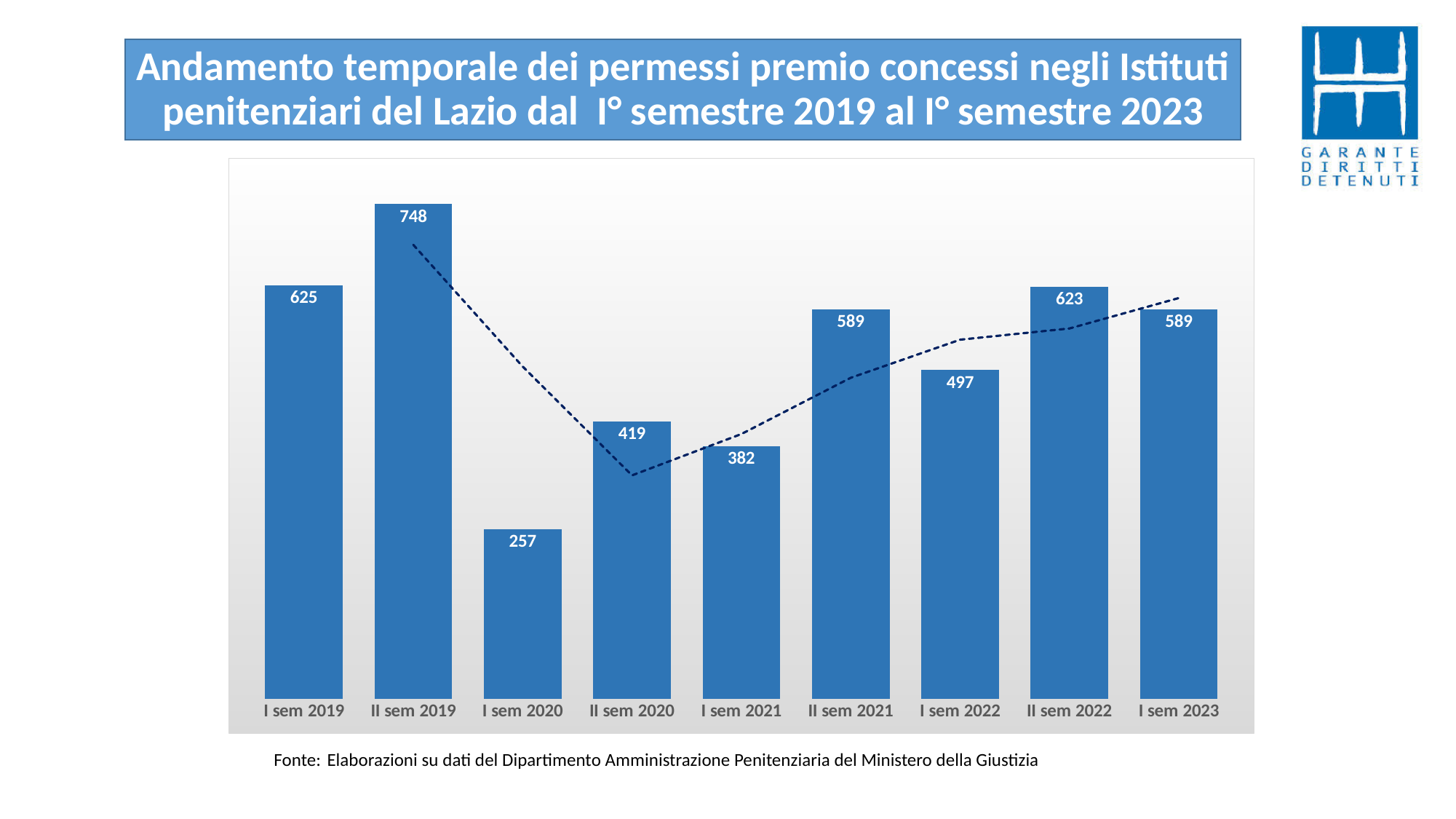
What is the value for II sem 2019? 748 What kind of chart is shown on the slide? Bar chart Which period has the lowest value? I sem 2020 Which is larger, the value for I sem 2019 or the value for II sem 2022? I sem 2019 What is the difference between the values for II sem 2019 and I sem 2020? 491 Do the values rise or fall from I sem 2020 to II sem 2021? Rise How many periods are shown on the x axis? 9 What is the value for I sem 2020? 257 What is the value for I sem 2023? 589 What is the value for I sem 2022? 497 What is the difference between the values for II sem 2022 and I sem 2022? 126 Which period has the highest value? II sem 2019